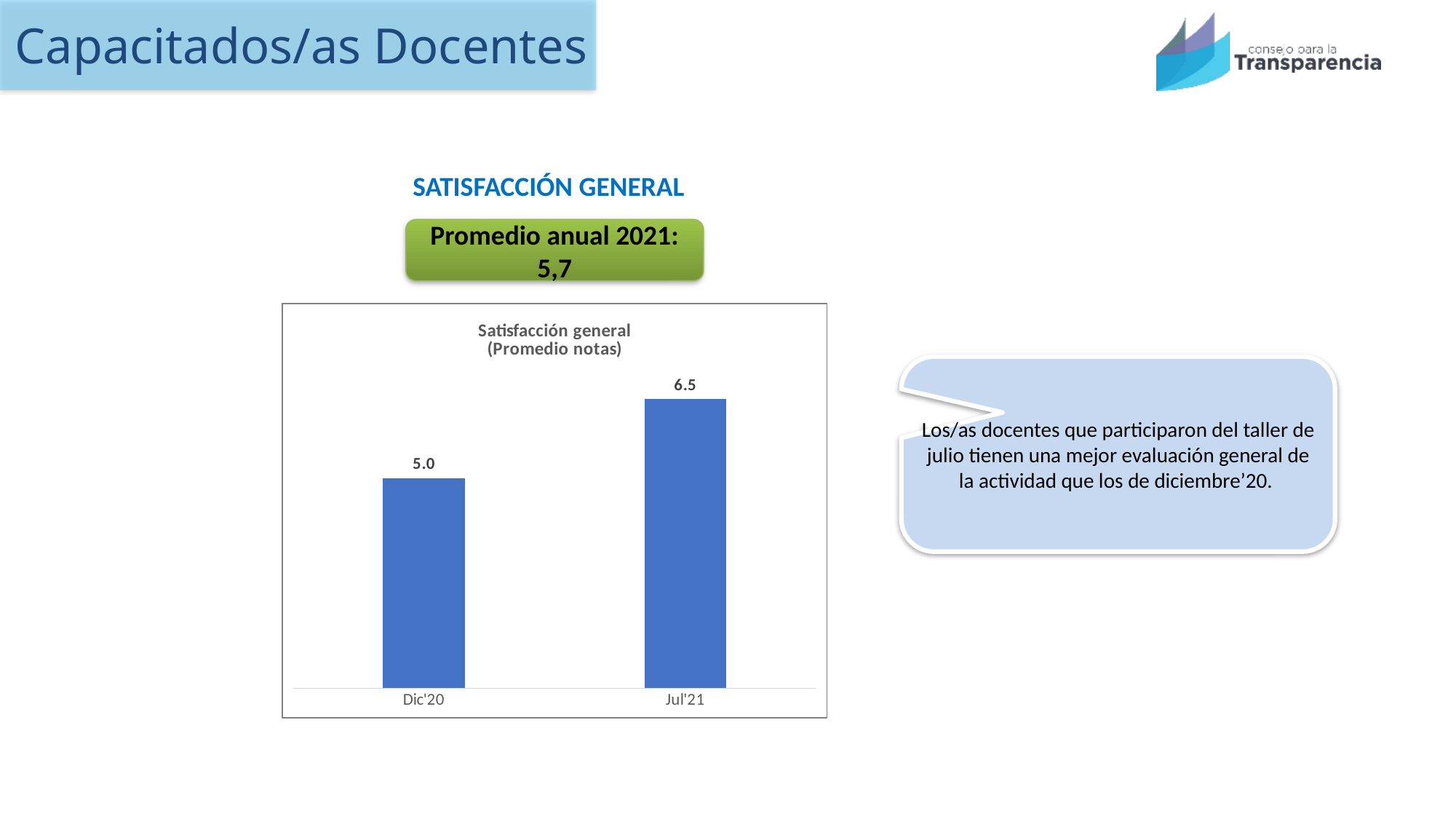
What kind of chart is shown on the slide? Bar chart What is the value for Jul'21 in the chart? 6.5 What is the title of the chart? Satisfacción general (Promedio notas) What colour are the bars in the chart? Blue Which category has the highest value in the chart? Jul'21 Do the values rise or fall from Dic'20 to Jul'21? Rise How many categories are shown in the chart? 2 What is the value for Dic'20 in the chart? 5.0 Which is larger, the value for Dic'20 or the value for Jul'21? Jul'21 Which category has the lowest value in the chart? Dic'20 What is the difference between the values for Jul'21 and Dic'20? 1.5